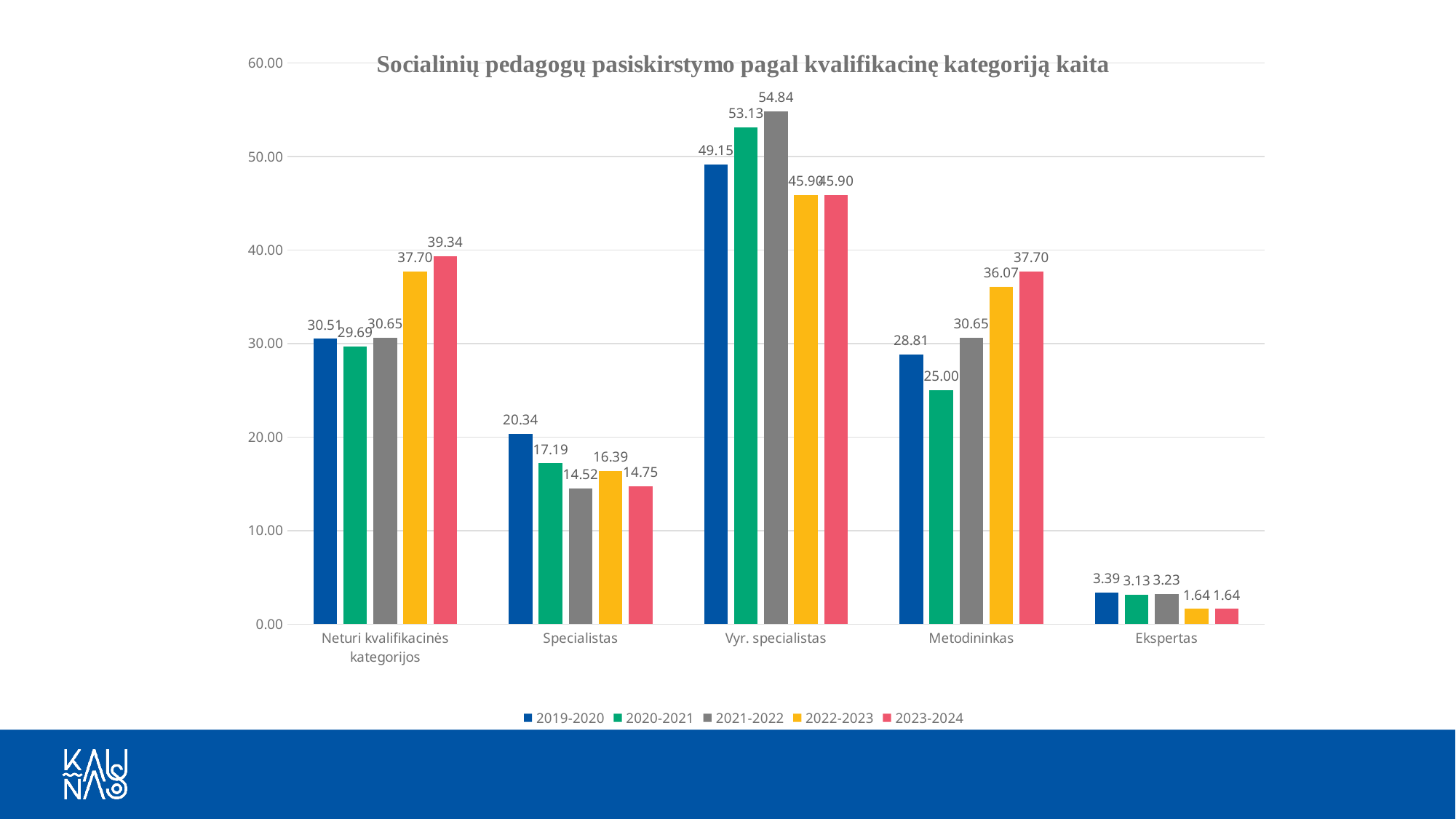
What is the difference between the 2023-2024 and 2019-2020 values for Metodininkas? 8.89 How many categories are shown on the x axis? 5 Do the values for Specialistas rise or fall from the 2019-2020 series to the 2021-2022 series? fall What is the value for Specialistas in the 2019-2020 series? 20.34 What is the title of the chart? Socialinių pedagogų pasiskirstymo pagal kvalifikacinę kategoriją kaita Which category has the highest value in the 2022-2023 series? Vyr. specialistas What is the value for Vyr. specialistas in the 2021-2022 series? 54.84 Which category has the lowest value in the 2019-2020 series? Ekspertas How many series does the legend list? 5 What type of chart is shown on the slide? bar chart What is the value for Ekspertas in the 2023-2024 series? 1.64 Which is larger for Neturi kvalifikacinės kategorijos: the 2022-2023 value or the 2023-2024 value? 2023-2024